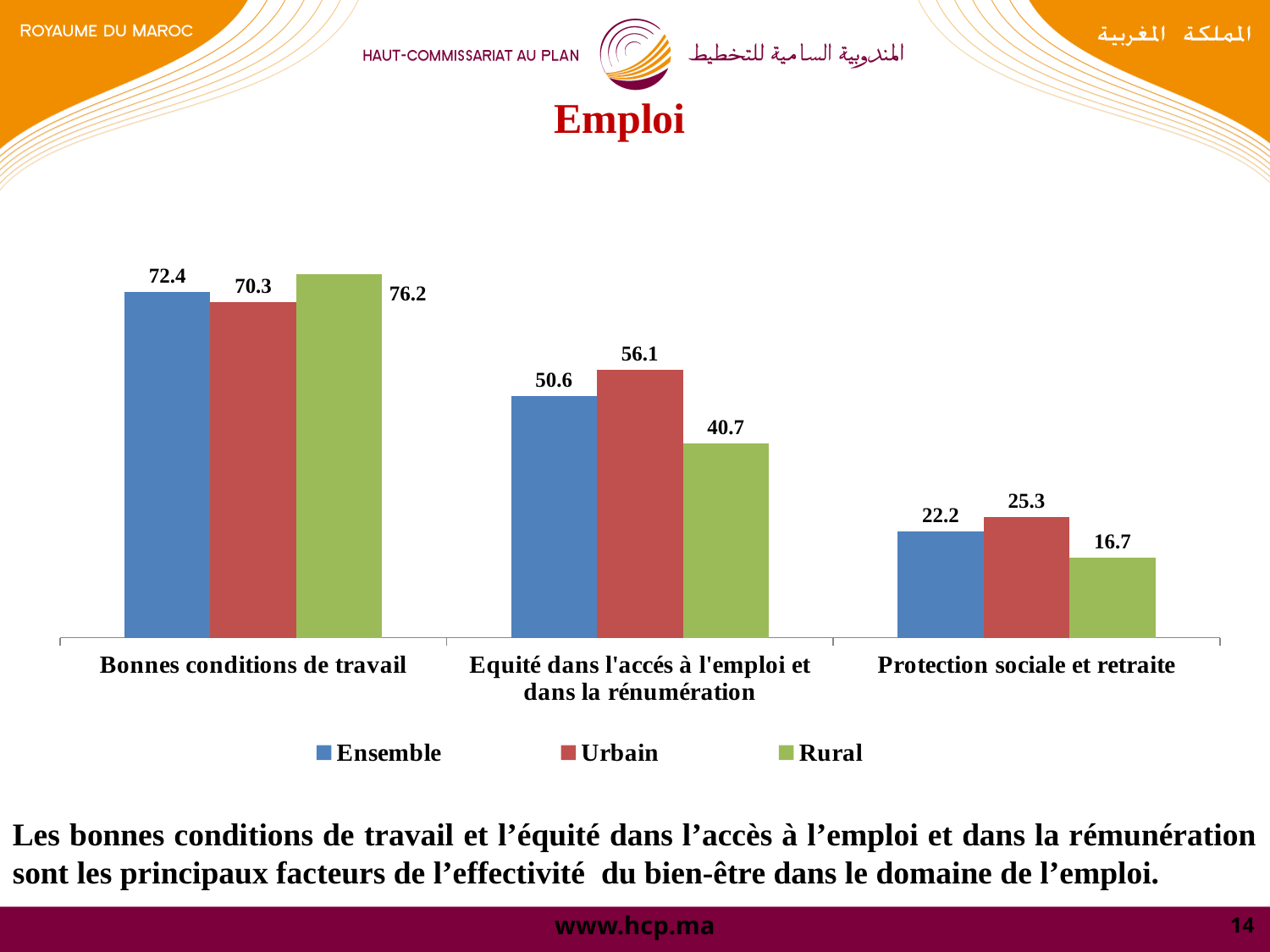
What is the Rural value for Bonnes conditions de travail? 76.2 How many series does the legend list? 3 What is the difference between the Rural and Ensemble values for Bonnes conditions de travail? 3.8 How many categories are shown on the x axis? 3 What is the Urbain value for Equité dans l'accés à l'emploi et dans la rénumération? 56.1 For Protection sociale et retraite, which is larger: the Urbain value or the Rural value? Urbain What is the difference between the Urbain and Rural values for Equité dans l'accés à l'emploi et dans la rénumération? 15.4 What kind of chart is shown on the slide? Bar chart Which category has the highest Ensemble value? Bonnes conditions de travail Which category has the lowest Rural value? Protection sociale et retraite What is the Ensemble value for Protection sociale et retraite? 22.2 Which series is shown in green in the legend? Rural